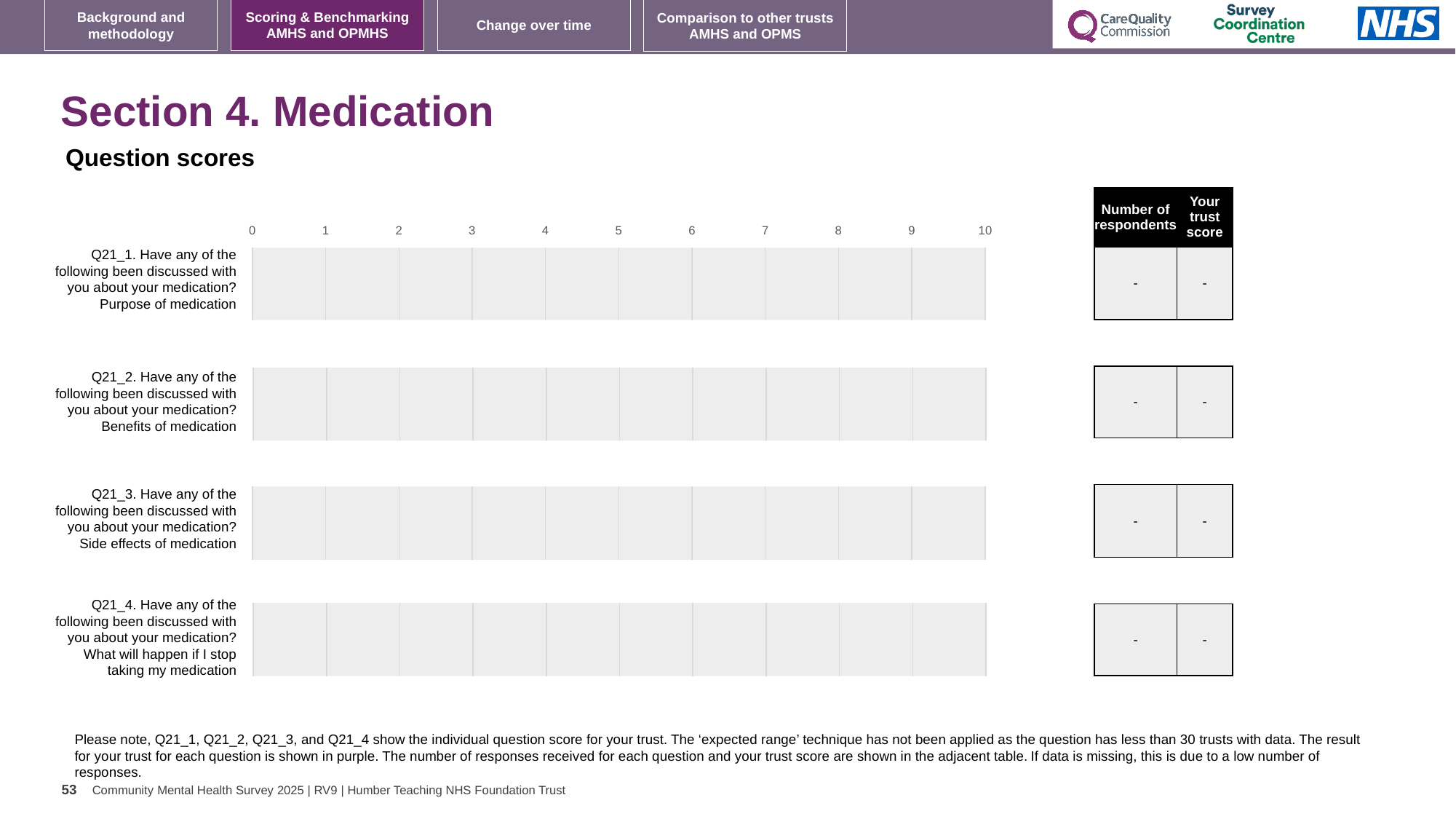
How many questions (categories) are shown in the chart area on this slide? 4 Is a bar plotted for Q21_1 (Purpose of medication) on the chart? No Which question label is listed first (at the top) of the chart area? Q21_1. Have any of the following been discussed with you about your medication? Purpose of medication What is the lowest value shown on the x axis of the question score charts? 0 What is the highest value shown on the x axis of the question score charts? 10 What is shown in the 'Number of respondents' column for Q21_4 (What will happen if I stop taking my medication)? - What kind of chart is used for the question scores on this slide? bar chart What is shown in the 'Your trust score' column for Q21_3 (Side effects of medication)? -